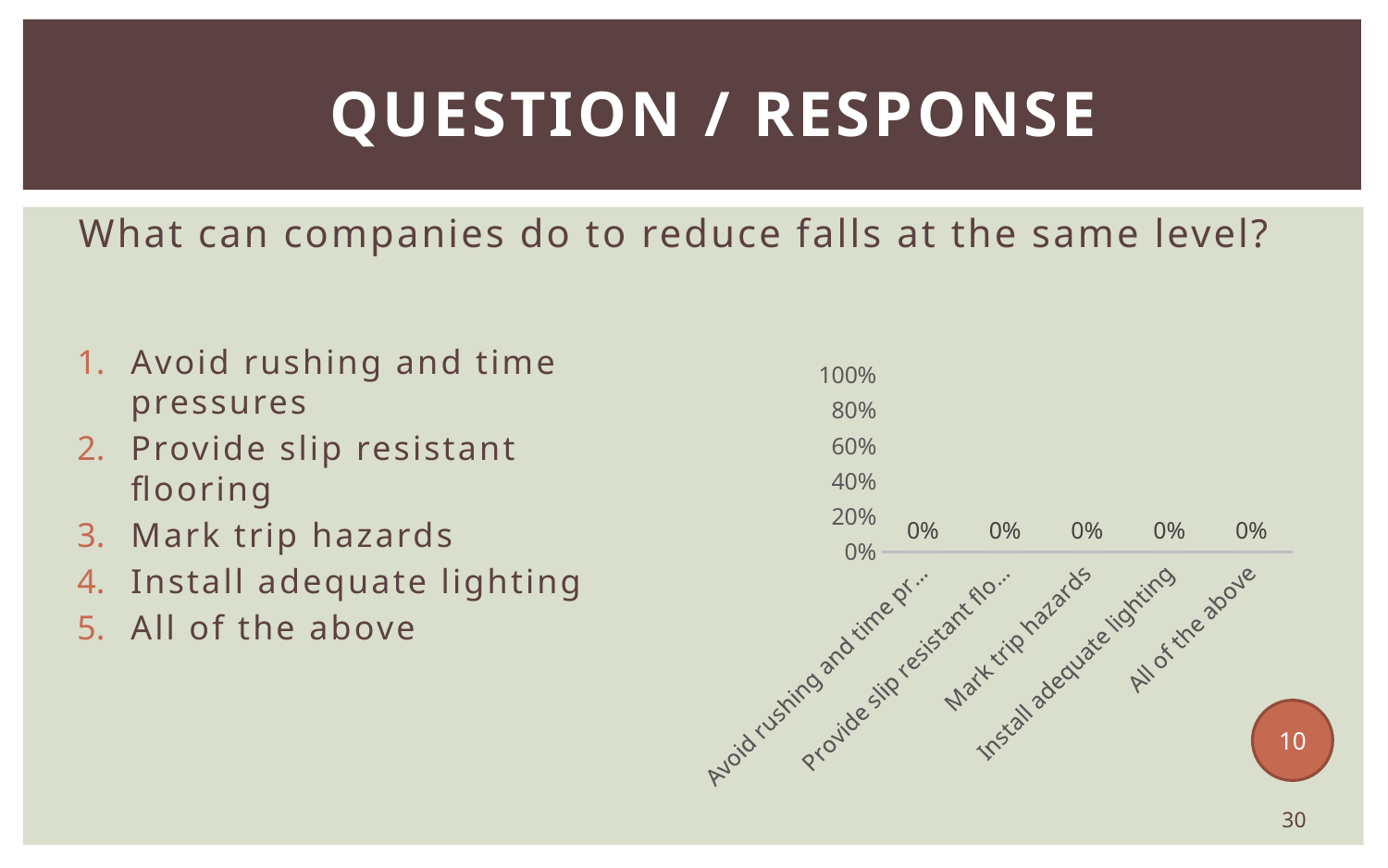
What is the highest value shown on the chart's vertical axis? 100% Is the value for Mark trip hazards greater or less than 20%? less Is the value for All of the above greater or less than 40%? less What is the label of the last category on the x axis? All of the above What is the value for Install adequate lighting? 0% What is the value for the first category, Avoid rushing and time pressures? 0% What is the value for All of the above? 0% How many categories are shown on the x axis of the chart? 5 What is the difference between the values for Mark trip hazards and All of the above? 0% What is the value for Mark trip hazards? 0% Do the values rise, fall, or stay flat across the categories from left to right? stay flat What kind of chart is shown on the slide? bar chart